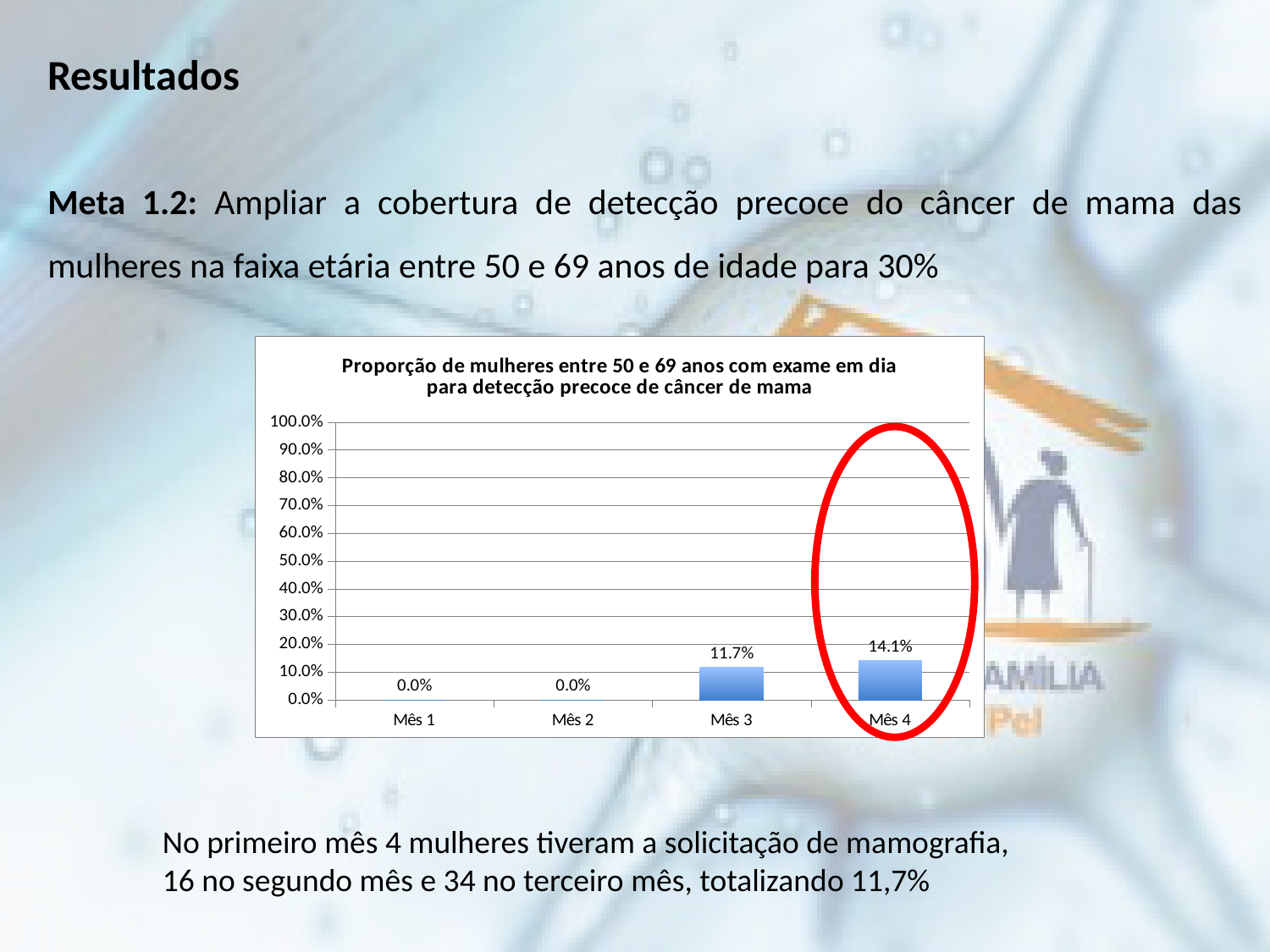
Is the value for Mês 4 greater or less than 20.0%? less What is the value for Mês 1? 0.0% Which month has the highest value? Mês 4 What kind of chart is shown on the slide? bar chart What is the difference between the values for Mês 4 and Mês 3? 2.4% What is the value for Mês 4? 14.1% What is the value for Mês 3? 11.7% Which month's bar is circled in red on the chart? Mês 4 What is the maximum value shown on the y axis? 100.0% Which is larger, the value for Mês 3 or the value for Mês 4? Mês 4 Do the values rise or fall from Mês 1 to Mês 4? rise How many months are shown on the x axis? 4